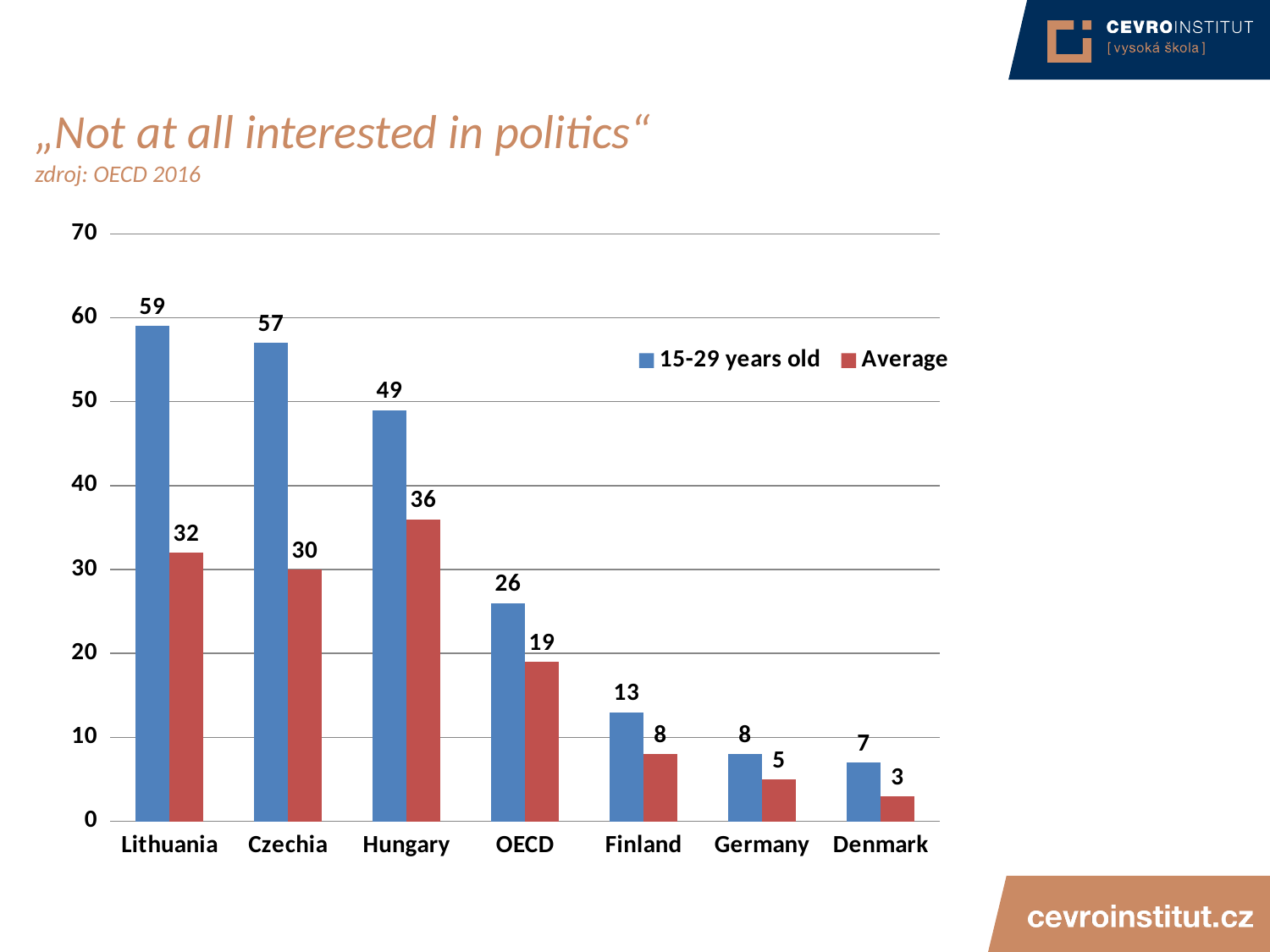
How many categories are shown on the x axis? 7 Which is larger: the Average value for Finland or the 15-29 years old value for Germany? They are equal (8) What kind of chart is shown on the slide? Bar chart What is the value for 15-29 years old in Lithuania? 59 Which category has the lowest Average value? Denmark Which country has the highest value for 15-29 years old? Lithuania How many series does the legend list? 2 Do the 15-29 years old values rise or fall from left to right along the x axis? Fall What is the Average value for Hungary? 36 Is the 15-29 years old value for Hungary greater or less than 40? greater What is the difference between the 15-29 years old value and the Average value for Czechia? 27 What is the value for 15-29 years old for the OECD? 26